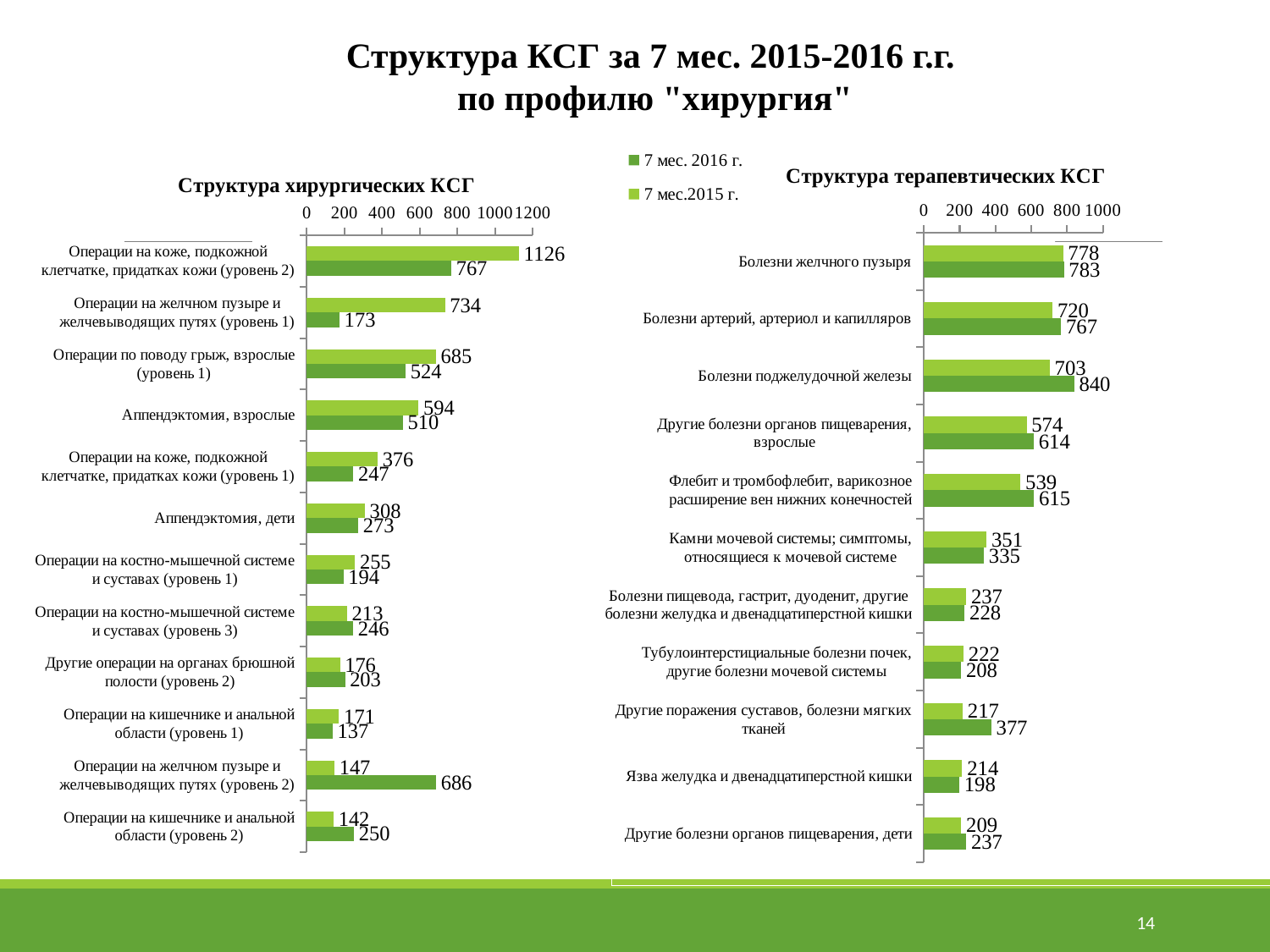
How many categories are shown in the "Структура хирургических КСГ" chart? 12 In the "Структура терапевтических КСГ" chart, what is the difference between the 7 мес. 2016 г. and 7 мес.2015 г. values for "Флебит и тромбофлебит, варикозное расширение вен нижних конечностей"? 76 In the "Структура терапевтических КСГ" chart, what is the value for "Болезни поджелудочной железы" for 7 мес. 2016 г.? 840 How many series does the legend list? 2 In the "Структура хирургических КСГ" chart, which category has the lowest value for 7 мес. 2016 г.? Операции на кишечнике и анальной области (уровень 1) In the "Структура хирургических КСГ" chart, what is the value for "Операции на коже, подкожной клетчатке, придатках кожи (уровень 2)" for 7 мес.2015 г.? 1126 In the "Структура терапевтических КСГ" chart, which is larger for "Другие поражения суставов, болезни мягких тканей": the 7 мес.2015 г. value or the 7 мес. 2016 г. value? 7 мес. 2016 г. What kind of chart is "Структура хирургических КСГ"? bar chart In the "Структура терапевтических КСГ" chart, which category has the highest value for 7 мес.2015 г.? Болезни желчного пузыря In the "Структура хирургических КСГ" chart, what is the value for "Операции на желчном пузыре и желчевыводящих путях (уровень 2)" for 7 мес. 2016 г.? 686 In the "Структура хирургических КСГ" chart, what is the difference between the 7 мес.2015 г. and 7 мес. 2016 г. values for "Операции на желчном пузыре и желчевыводящих путях (уровень 1)"? 561 How many categories are shown in the "Структура терапевтических КСГ" chart? 11